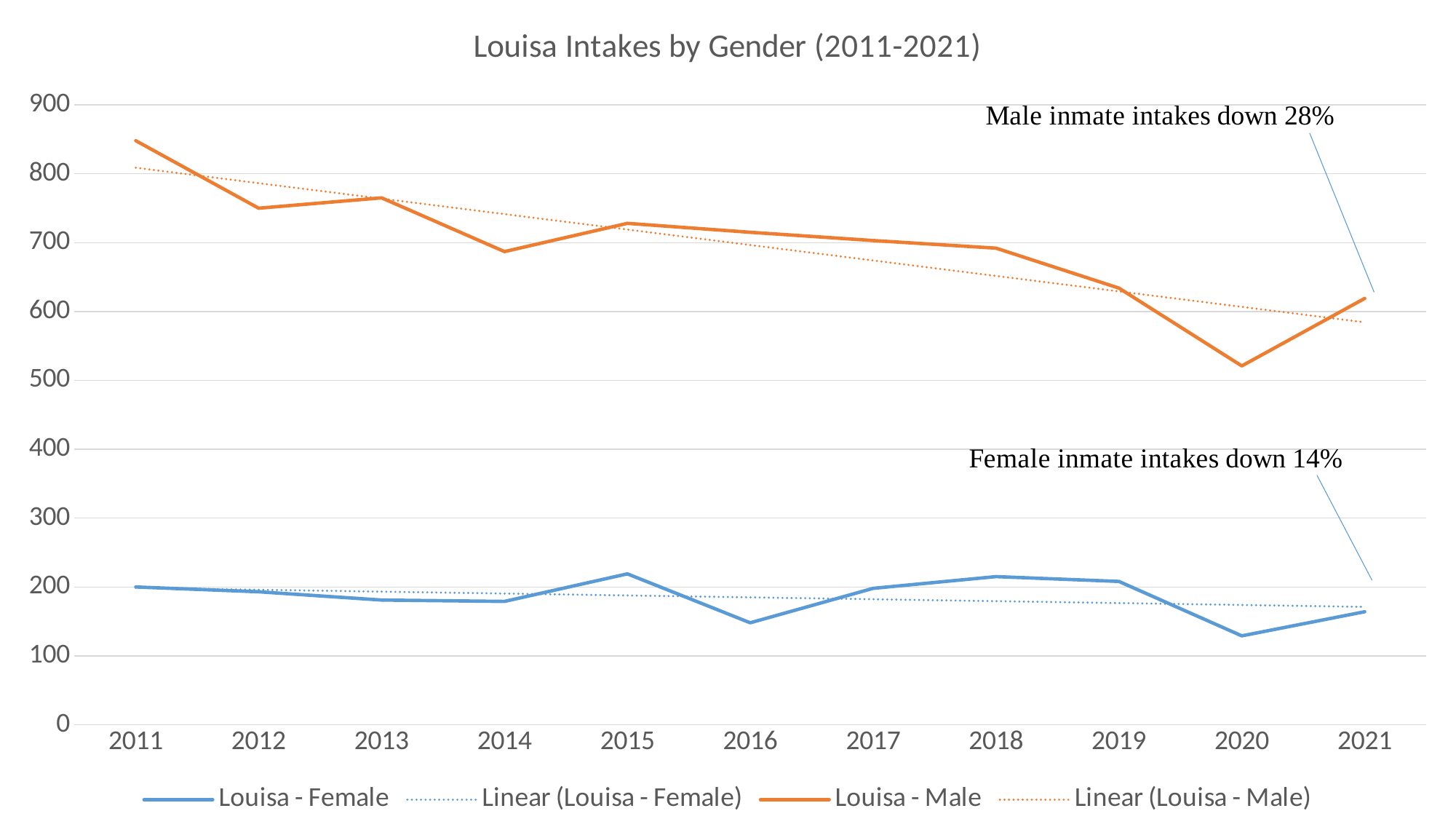
What kind of chart is shown on the slide? line chart In which year is the Louisa - Female series at its lowest? 2020 In which year is the Louisa - Male series at its lowest? 2020 How many entries does the chart legend list? 4 Which series has the larger value in 2018, Louisa - Male or Louisa - Female? Louisa - Male Is the value for Louisa - Female in 2016 greater or less than 200? less According to the annotation on the chart, by what percentage are male inmate intakes down? 28% Is the value for Louisa - Male in 2011 greater or less than 800? greater In which year is the Louisa - Male series at its highest? 2011 What is the title of the chart? Louisa Intakes by Gender (2011-2021) How many years are plotted along the x axis? 11 Is the value for Louisa - Male in 2020 greater or less than 600? less